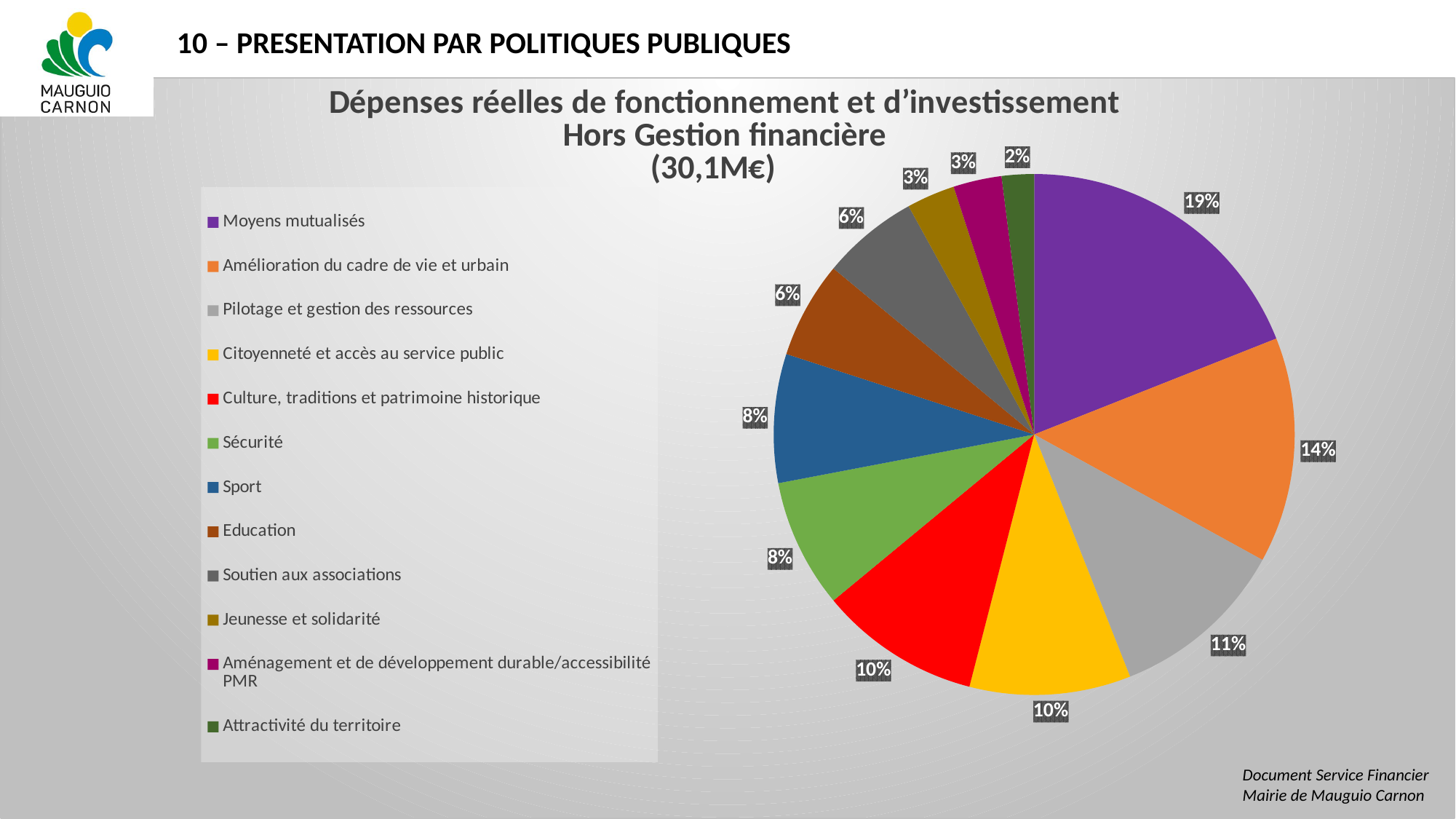
What is the value shown for Sport? 8% What total amount is given in the chart title? 30,1M€ Which is larger, the share for Sécurité or the share for Education? Sécurité What is the difference between the shares of Moyens mutualisés and Amélioration du cadre de vie et urbain? 5% What is the value shown for Amélioration du cadre de vie et urbain? 14% What is the value shown for Attractivité du territoire? 2% How many categories does the legend list? 12 Which category has the largest slice of the pie? Moyens mutualisés What kind of chart is shown on the slide? Pie chart What share of the pie does Moyens mutualisés represent? 19% What is the value shown for Pilotage et gestion des ressources? 11% Which category has the smallest slice of the pie? Attractivité du territoire